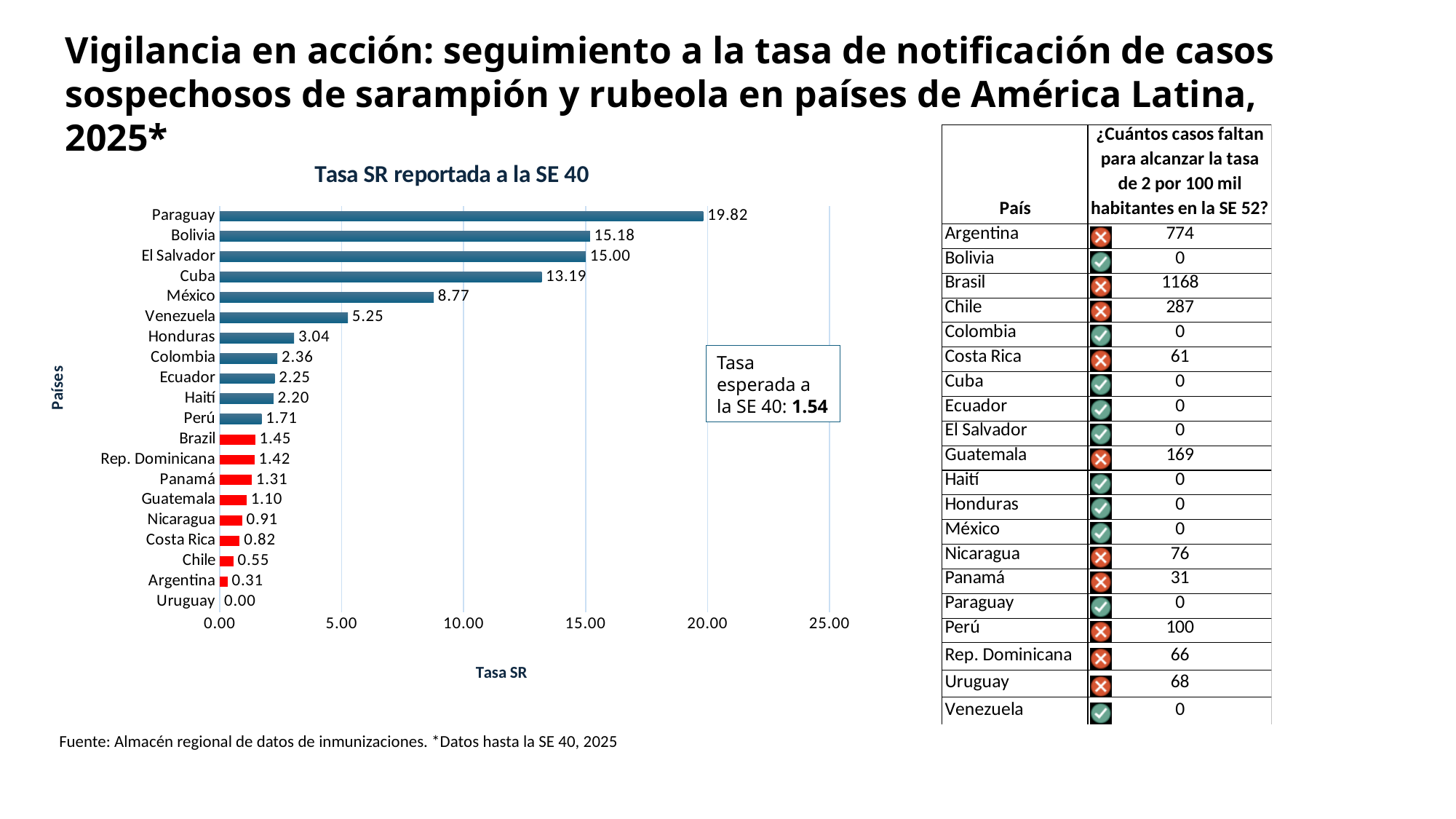
What is the Tasa SR value for Paraguay? 19.82 Which has a higher Tasa SR, Honduras or Colombia? Honduras Which country has the highest Tasa SR in the chart? Paraguay What is the Tasa SR value for Guatemala? 1.10 How many countries are shown in the bar chart? 20 What is the difference between the Tasa SR of Cuba and Venezuela? 7.94 What is the difference between the Tasa SR of Bolivia and El Salvador? 0.18 Is the Tasa SR value for Cuba greater or less than 10.00? greater What is the expected rate (tasa esperada) at SE 40 shown in the text box on the chart? 1.54 What is the Tasa SR value for México? 8.77 Which country has the lowest Tasa SR in the chart? Uruguay What type of chart is used to show the Tasa SR reportada a la SE 40? Bar chart